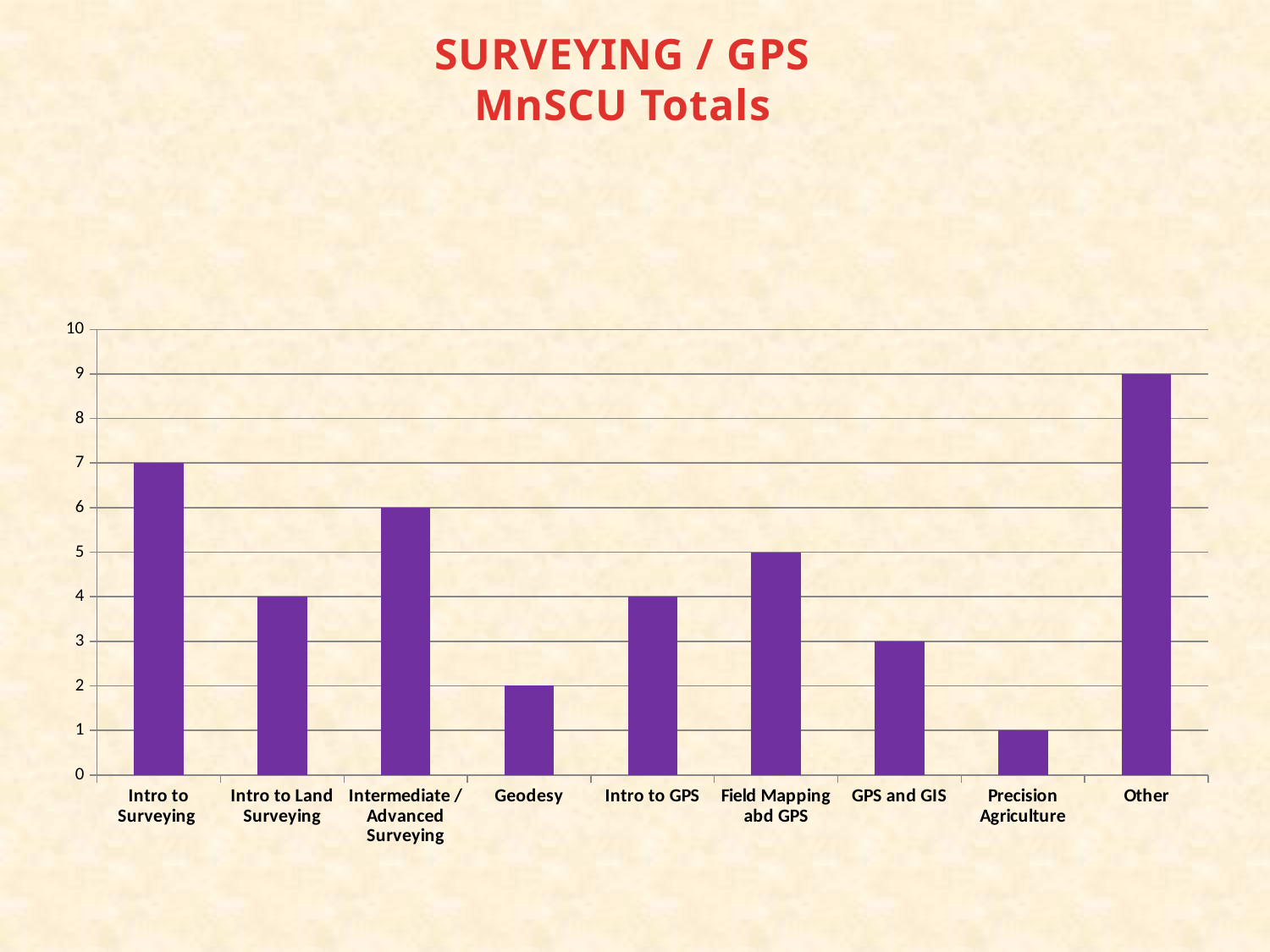
Is the value for Intro to GPS greater or less than 5? less What is the value for Geodesy? 2 What is the value for Intro to Surveying? 7 Which category has the highest value? Other How many categories are shown on the x axis? 9 Which category has the lowest value? Precision Agriculture What kind of chart is shown on the slide? bar chart What is the value for Other? 9 Which is larger, the value for Intermediate / Advanced Surveying or the value for GPS and GIS? Intermediate / Advanced Surveying What is the value for Field Mapping abd GPS? 5 What is the title of the chart? SURVEYING / GPS MnSCU Totals What is the difference between the values for Other and Intro to Surveying? 2